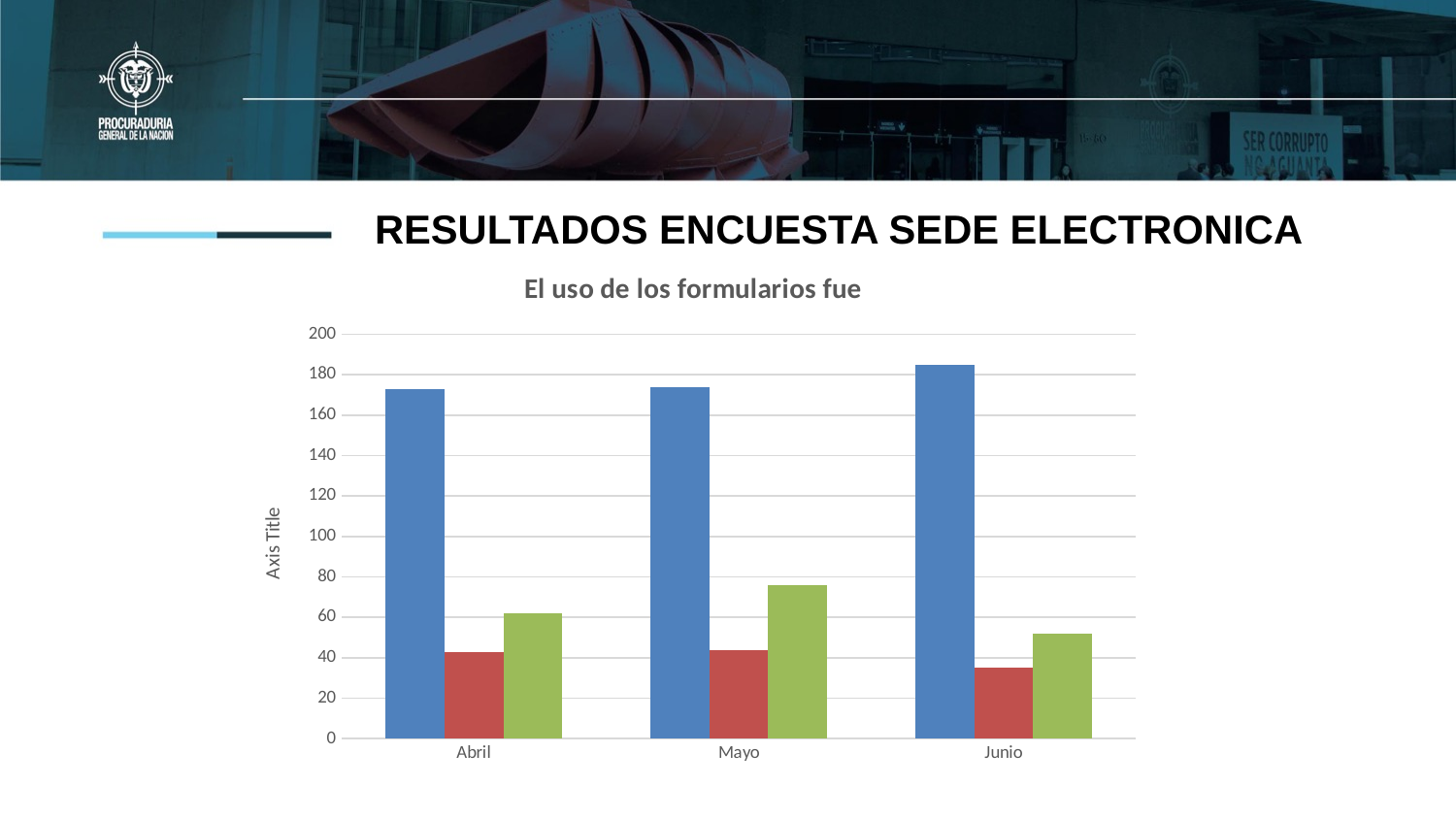
What is the title of the chart? El uso de los formularios fue Which is larger, the green bar for Mayo or the green bar for Junio? Mayo Is the value of the blue bar for Abril greater or less than 160? greater How many bars are plotted for each month in the chart? 3 How many categories are shown on the x axis of the chart? 3 Is the value of the blue bar for Junio greater or less than 160? greater Which month has the tallest blue bar? Junio Which month has the shortest green bar? Junio What kind of chart is shown on the slide? bar chart Is the value of the green bar for Mayo greater or less than 60? greater What is the label on the vertical axis of the chart? Axis Title